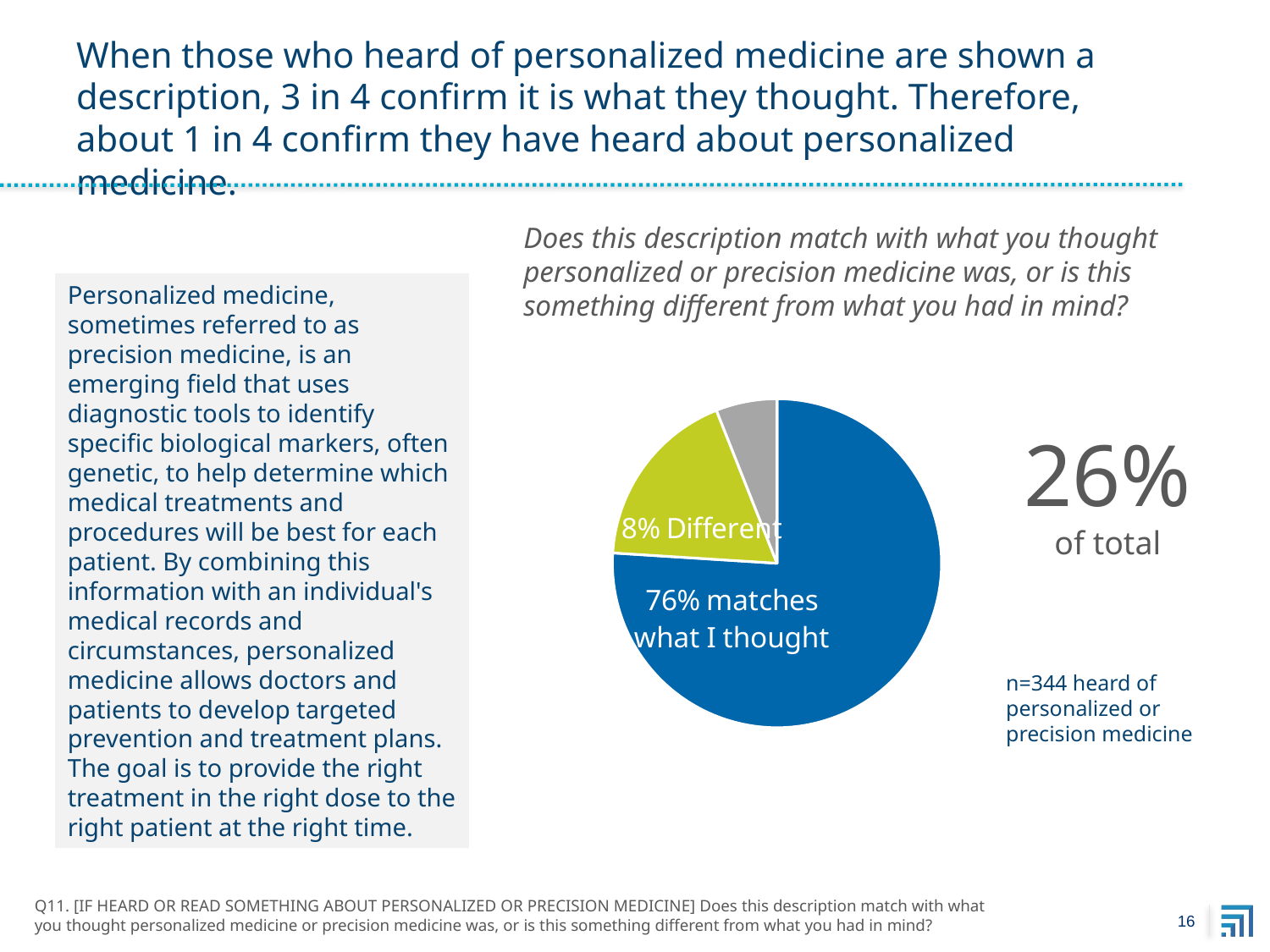
Which is larger: the share that said the description matches what they thought, or the share that said it was different? matches what I thought How many slices does the pie chart have? 3 What kind of chart is shown on the slide? pie chart Is the share of respondents who said the description matches what they thought greater or less than 50%? greater What is the sample size (n) noted next to the pie chart? n=344 Which labelled slice of the pie chart is the largest? 76% matches what I thought What share of the pie does the 'matches what I thought' slice represent? 76% What percentage of respondents said the description matches what they thought? 76% What large percentage figure is shown to the right of the pie chart, labelled 'of total'? 26%